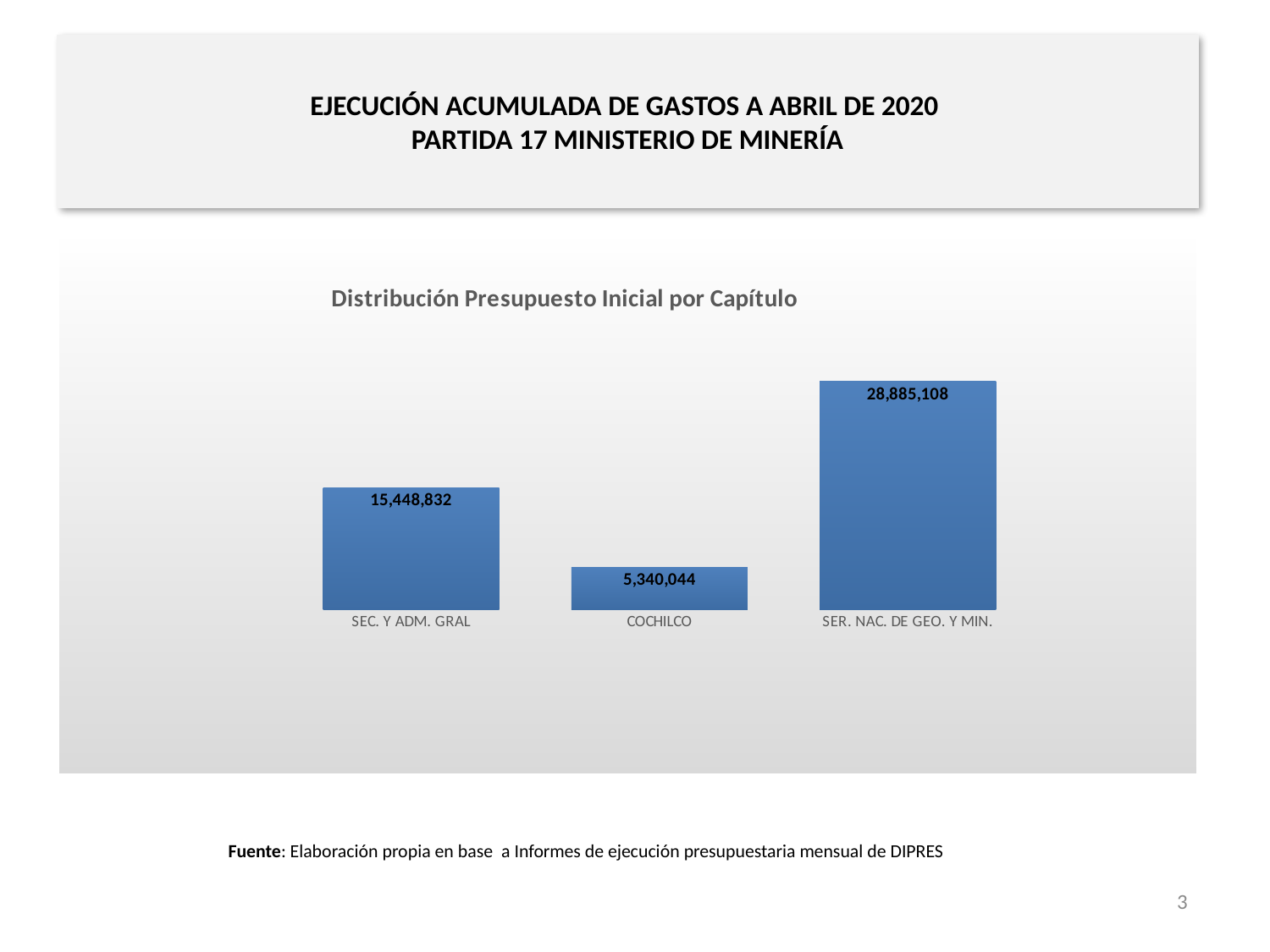
What is the title of the chart? Distribución Presupuesto Inicial por Capítulo Which category has the lowest value? COCHILCO Which is larger, the value for SEC. Y ADM. GRAL or the value for COCHILCO? SEC. Y ADM. GRAL What is the value for SEC. Y ADM. GRAL? 15,448,832 What kind of chart is shown on the slide? Bar chart How many categories are shown in the chart? 3 What is the difference between the values for SER. NAC. DE GEO. Y MIN. and SEC. Y ADM. GRAL? 13,436,276 Which category has the highest value? SER. NAC. DE GEO. Y MIN. What is the difference between the values for SEC. Y ADM. GRAL and COCHILCO? 10,108,788 What colour are the bars in the chart? Blue What is the value for COCHILCO? 5,340,044 What is the value for SER. NAC. DE GEO. Y MIN.? 28,885,108